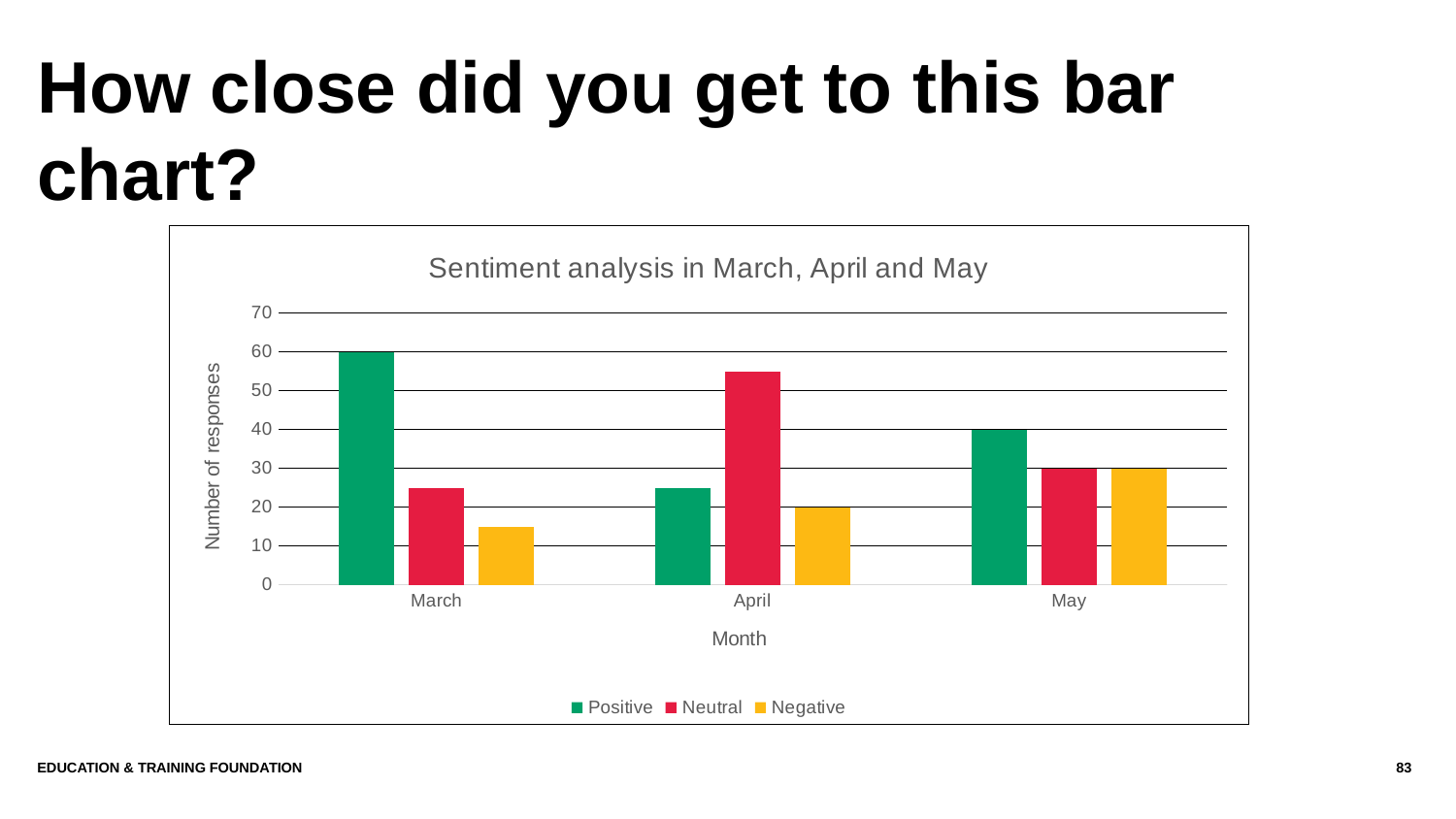
What is the title of the chart? Sentiment analysis in March, April and May In which month is the Negative bar lowest? March What is the number of Positive responses in May? 40 In which month is the Neutral bar highest? April Is the value for Neutral in March greater or less than 20? greater What is the number of Positive responses in March? 60 Do the Negative values rise or fall from March to May? rise In April, which is larger: Positive or Neutral? Neutral What kind of chart is shown on the slide? bar chart How many series does the legend list? 3 What is the number of Negative responses in April? 20 How many months are shown on the x axis? 3